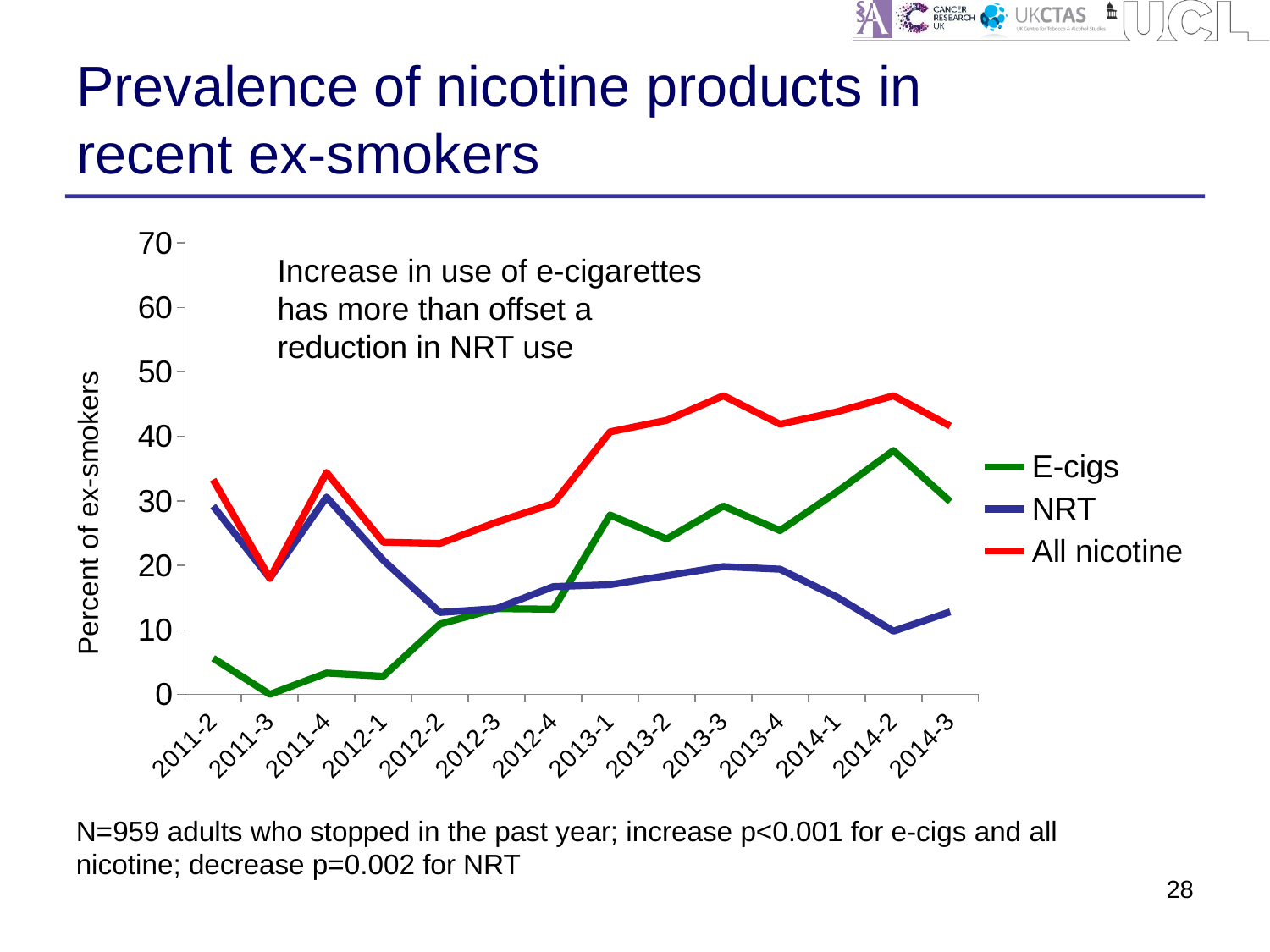
How many time periods are shown along the x axis? 14 How many series does the legend list? 3 In which period is the E-cigs value highest? 2014-2 In 2014-3, which is higher, E-cigs or NRT? E-cigs Overall, does the E-cigs line rise or fall from 2011-2 to 2014-3? Rise What is the label on the y axis? Percent of ex-smokers Is the value for All nicotine in 2012-2 greater or less than 30? less Is the value for E-cigs in 2011-2 greater or less than 10? less Is the value for All nicotine in 2013-3 greater or less than 40? greater What kind of chart is shown on the slide? Line chart In 2011-2, which is higher, E-cigs or NRT? NRT Overall, does the NRT line rise or fall from 2011-2 to 2014-3? Fall